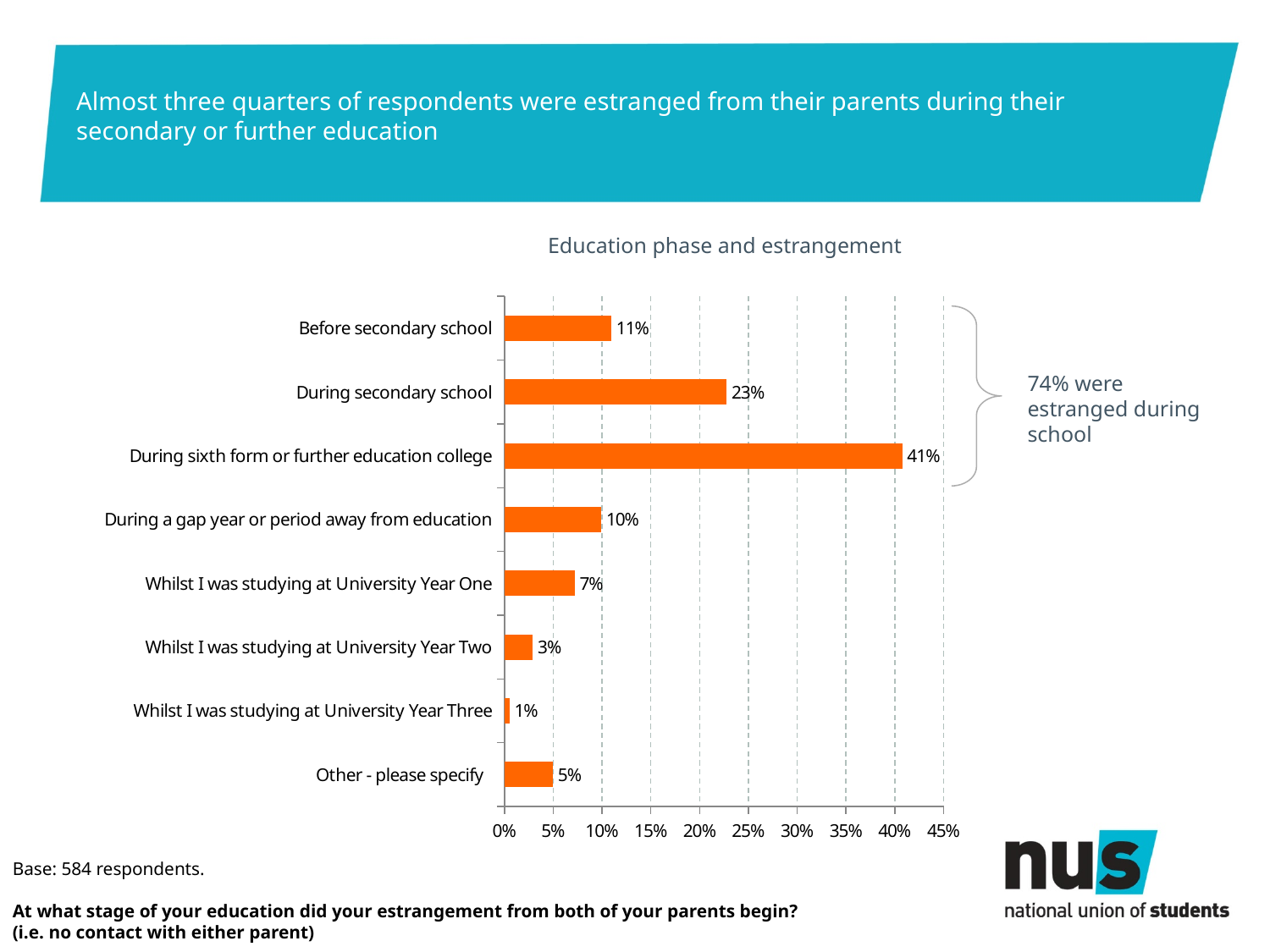
Which is larger: the value for 'During a gap year or period away from education' or the value for 'Whilst I was studying at University Year One'? During a gap year or period away from education Which education phase has the highest percentage of respondents? During sixth form or further education college What percentage of respondents were estranged whilst studying at University Year Two? 3% What is the value for 'Before secondary school'? 11% How many education phase categories are shown in the chart? 8 What percentage of respondents were estranged during sixth form or further education college? 41% What type of chart is shown on the slide? Bar chart What is the difference in percentage points between 'During sixth form or further education college' and 'During secondary school'? 18 Which education phase has the lowest percentage of respondents? Whilst I was studying at University Year Three Is the value for 'During secondary school' greater or less than 20%? greater What is the title of the chart? Education phase and estrangement According to the annotation next to the bracket, what percentage were estranged during school? 74%